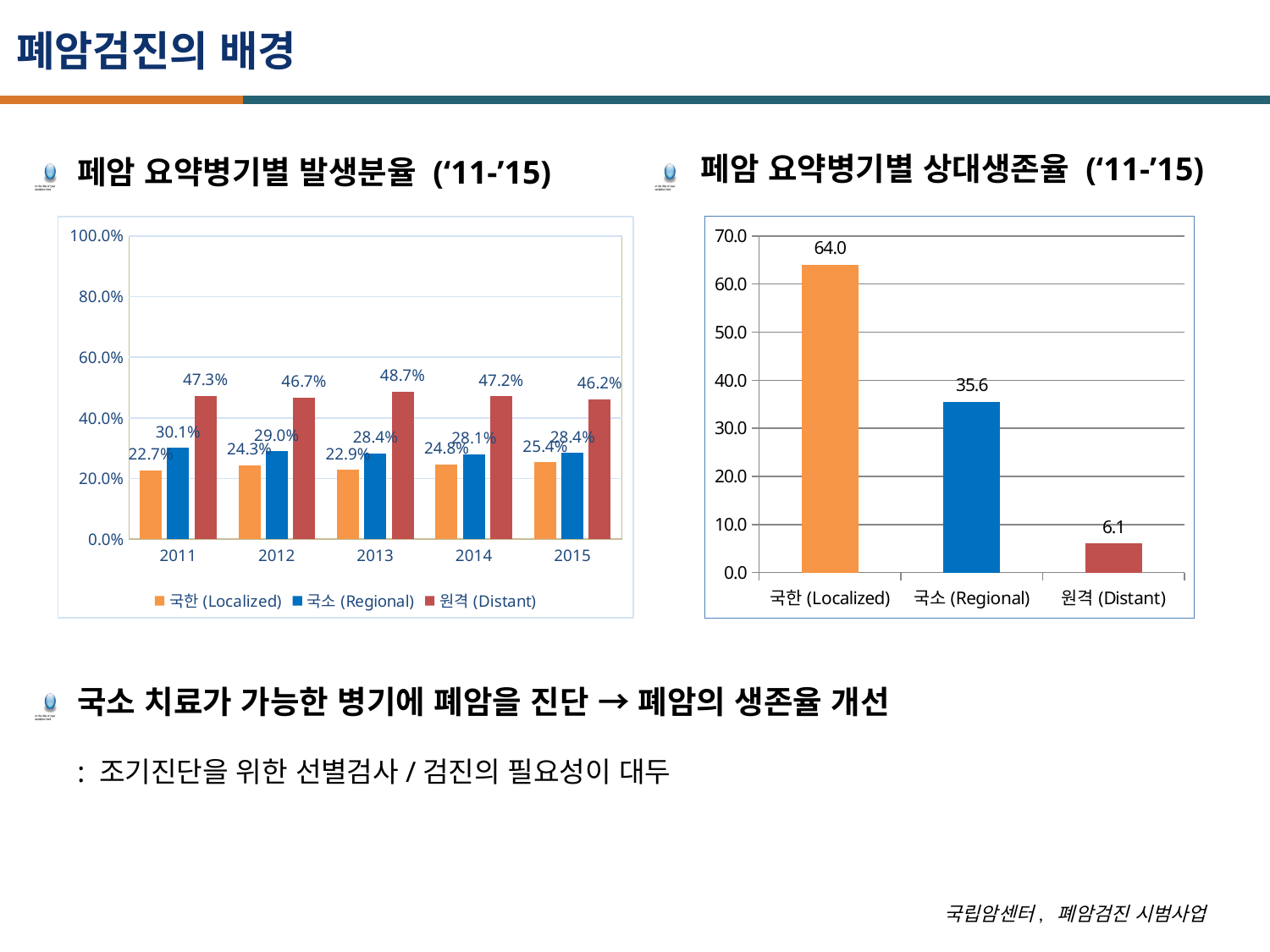
In the left chart (폐암 요약병기별 발생분율), how many series does the legend list? 3 In the left chart (폐암 요약병기별 발생분율), what is the value for 국한 (Localized) in 2015? 25.4% In the left chart (폐암 요약병기별 발생분율), what is the difference between the 원격 (Distant) and 국한 (Localized) values in 2012? 22.4% In the right chart (폐암 요약병기별 상대생존율), which category has the lowest value? 원격 (Distant) In the right chart (폐암 요약병기별 상대생존율), how many categories are shown on the x axis? 3 In the right chart (폐암 요약병기별 상대생존율), what kind of chart is it? Bar chart In the left chart (폐암 요약병기별 발생분율), what colour represents 원격 (Distant) in the legend? Red In the right chart (폐암 요약병기별 상대생존율), what is the difference between the values for 국한 (Localized) and 국소 (Regional)? 28.4 In the left chart (폐암 요약병기별 발생분율), which is larger in 2011: 국소 (Regional) or 국한 (Localized)? 국소 (Regional) In the right chart (폐암 요약병기별 상대생존율), what is the value for 국한 (Localized)? 64.0 In the left chart (폐암 요약병기별 발생분율), in which year is the 원격 (Distant) value highest? 2013 In the left chart (폐암 요약병기별 발생분율), what is the value for 원격 (Distant) in 2013? 48.7%